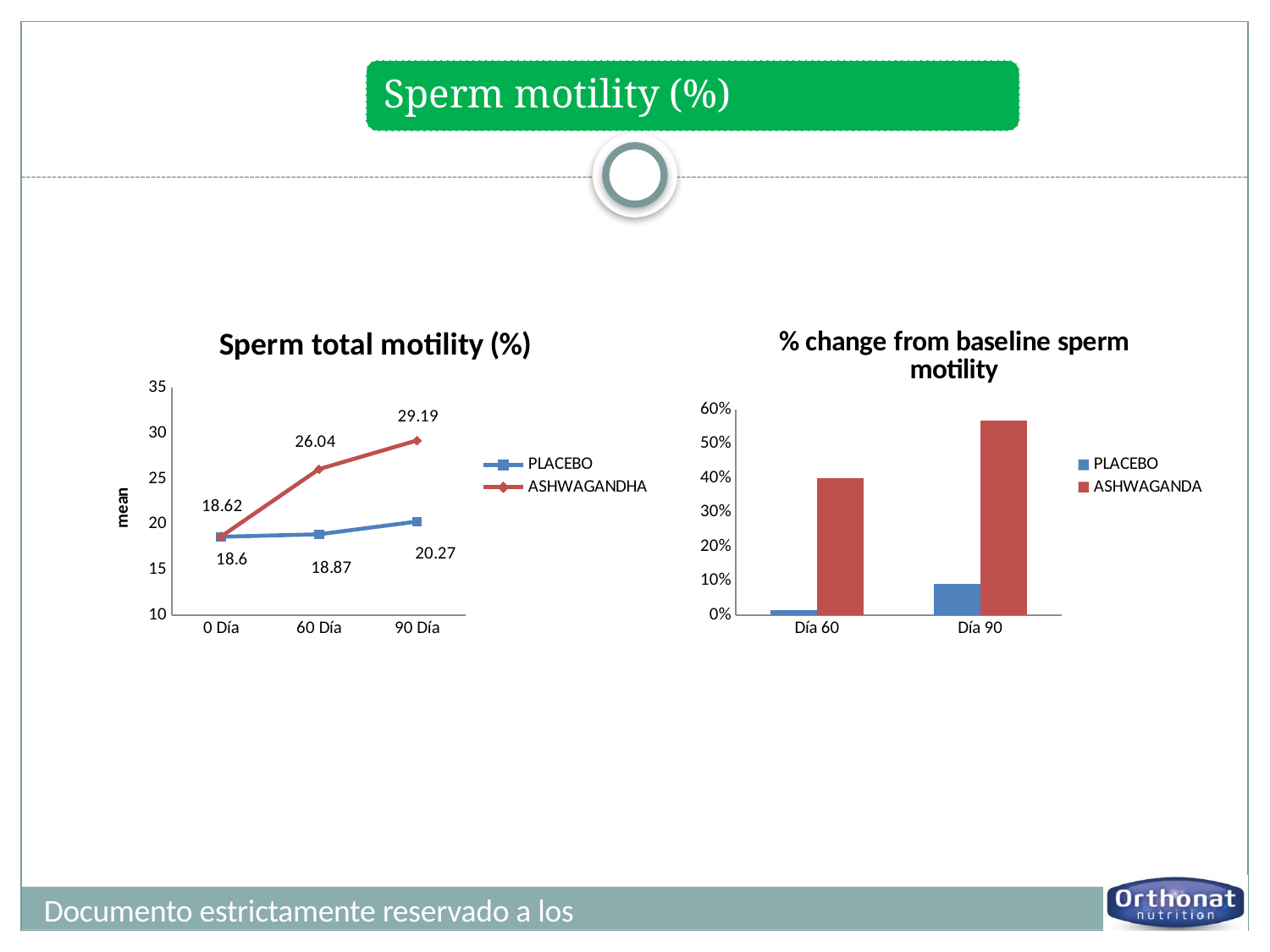
How many series does the legend of the '% change from baseline sperm motility' chart list? 2 What kind of chart is '% change from baseline sperm motility'? bar chart In the 'Sperm total motility (%)' chart, what is the ASHWAGANDHA value at 0 Día? 18.62 How many time points are shown on the x axis of the 'Sperm total motility (%)' chart? 3 In the 'Sperm total motility (%)' chart, which series has the higher value at 60 Día? ASHWAGANDHA In the '% change from baseline sperm motility' chart, is the PLACEBO value for Día 90 greater or less than 10%? less In the 'Sperm total motility (%)' chart, what is the difference between the ASHWAGANDHA and PLACEBO values at 90 Día? 8.92 In the '% change from baseline sperm motility' chart, is the ASHWAGANDA value for Día 90 greater or less than 50%? greater In the 'Sperm total motility (%)' chart, what is the ASHWAGANDHA value at 90 Día? 29.19 What kind of chart is 'Sperm total motility (%)'? line chart In the 'Sperm total motility (%)' chart, what is the PLACEBO value at 60 Día? 18.87 In the 'Sperm total motility (%)' chart, does the ASHWAGANDHA series rise or fall from 0 Día to 90 Día? rise